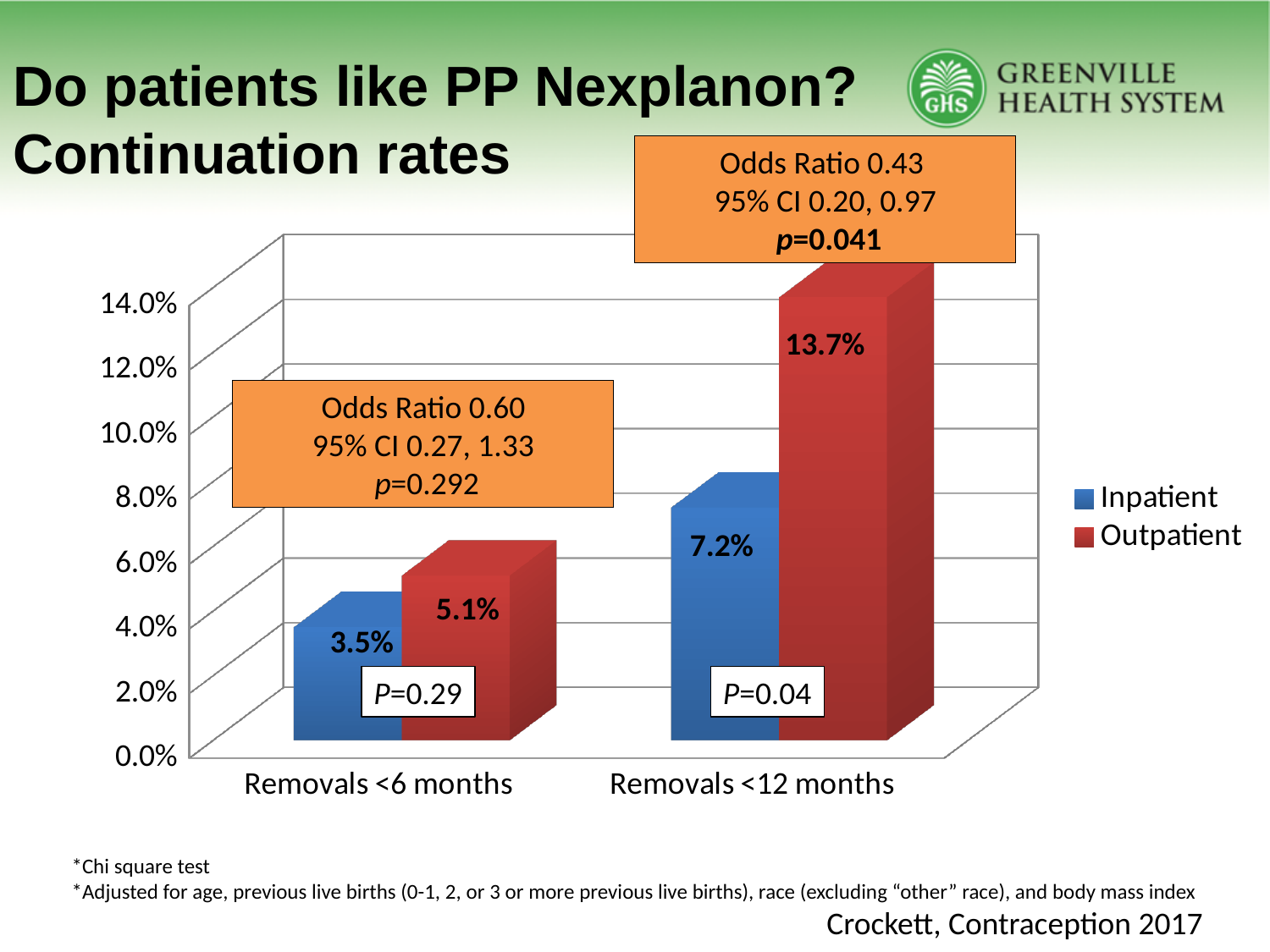
How many categories are shown on the x axis? 2 What kind of chart is shown on the slide? Bar chart What is the Outpatient value for Removals <12 months? 13.7% How many series does the legend list? 2 What is the difference between the Outpatient and Inpatient values for Removals <12 months? 6.5% What is the difference between the Outpatient and Inpatient values for Removals <6 months? 1.6% Which bar has the lowest value on the chart? Inpatient, Removals <6 months For Removals <6 months, which is larger, Inpatient or Outpatient? Outpatient Which bar has the highest value on the chart? Outpatient, Removals <12 months What is the Outpatient value for Removals <6 months? 5.1% What is the Inpatient value for Removals <12 months? 7.2% What is the Inpatient value for Removals <6 months? 3.5%